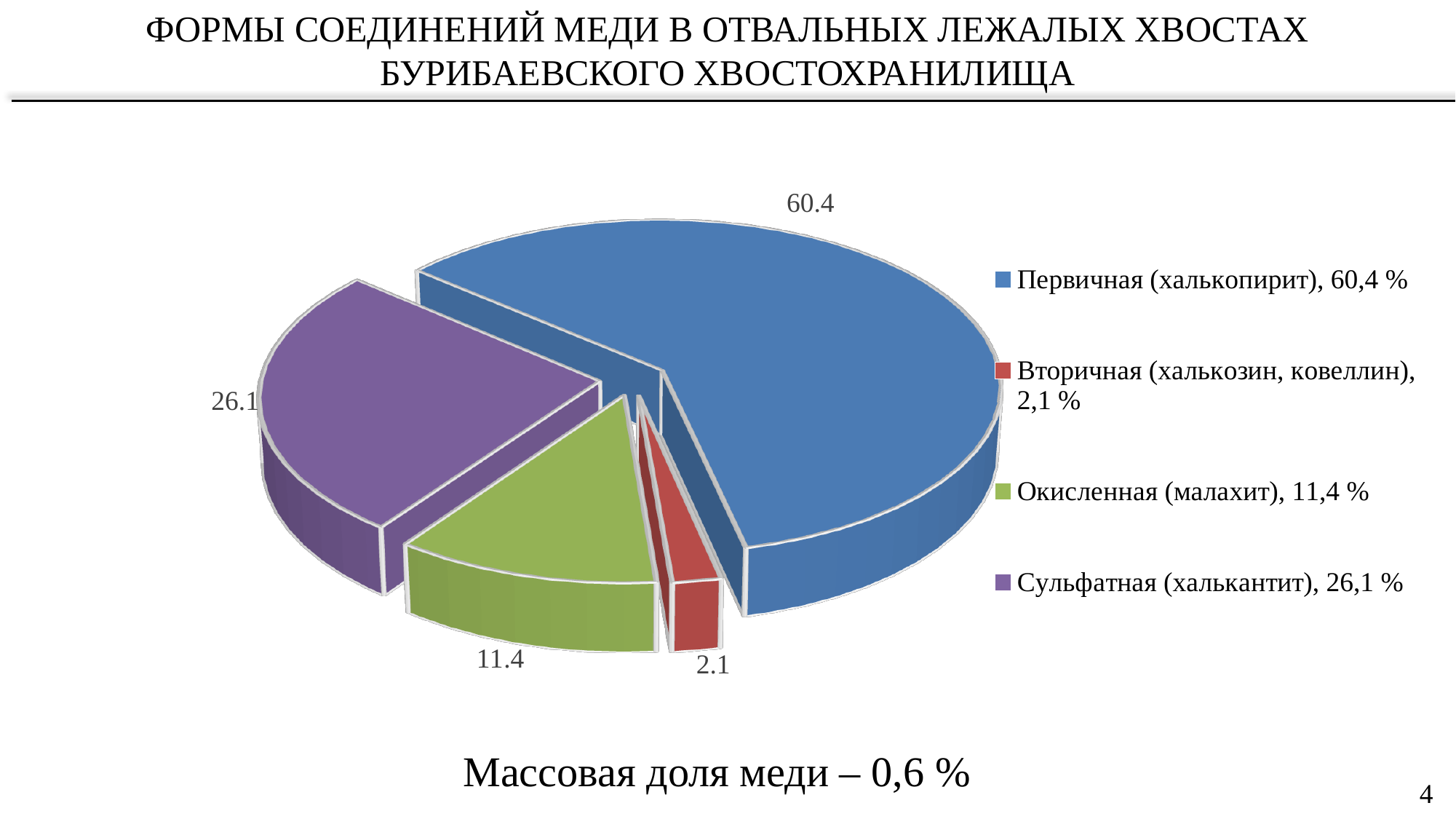
What is the difference between the values for Сульфатная (халькантит) and Окисленная (малахит)? 14.7 What is the mass fraction of copper stated below the chart? 0,6 % How many slices does the pie chart have? 4 What is the value shown for Сульфатная (халькантит)? 26.1 What colour is the slice for Сульфатная (халькантит)? purple Which category has the largest slice of the pie? Первичная (халькопирит) Which is larger, the value for Окисленная (малахит) or the value for Вторичная (халькозин, ковеллин)? Окисленная (малахит) What is the value shown for Вторичная (халькозин, ковеллин)? 2.1 Which category has the smallest slice of the pie? Вторичная (халькозин, ковеллин) What is the value shown for Первичная (халькопирит)? 60.4 What kind of chart is shown on the slide? pie chart What is the value shown for Окисленная (малахит)? 11.4